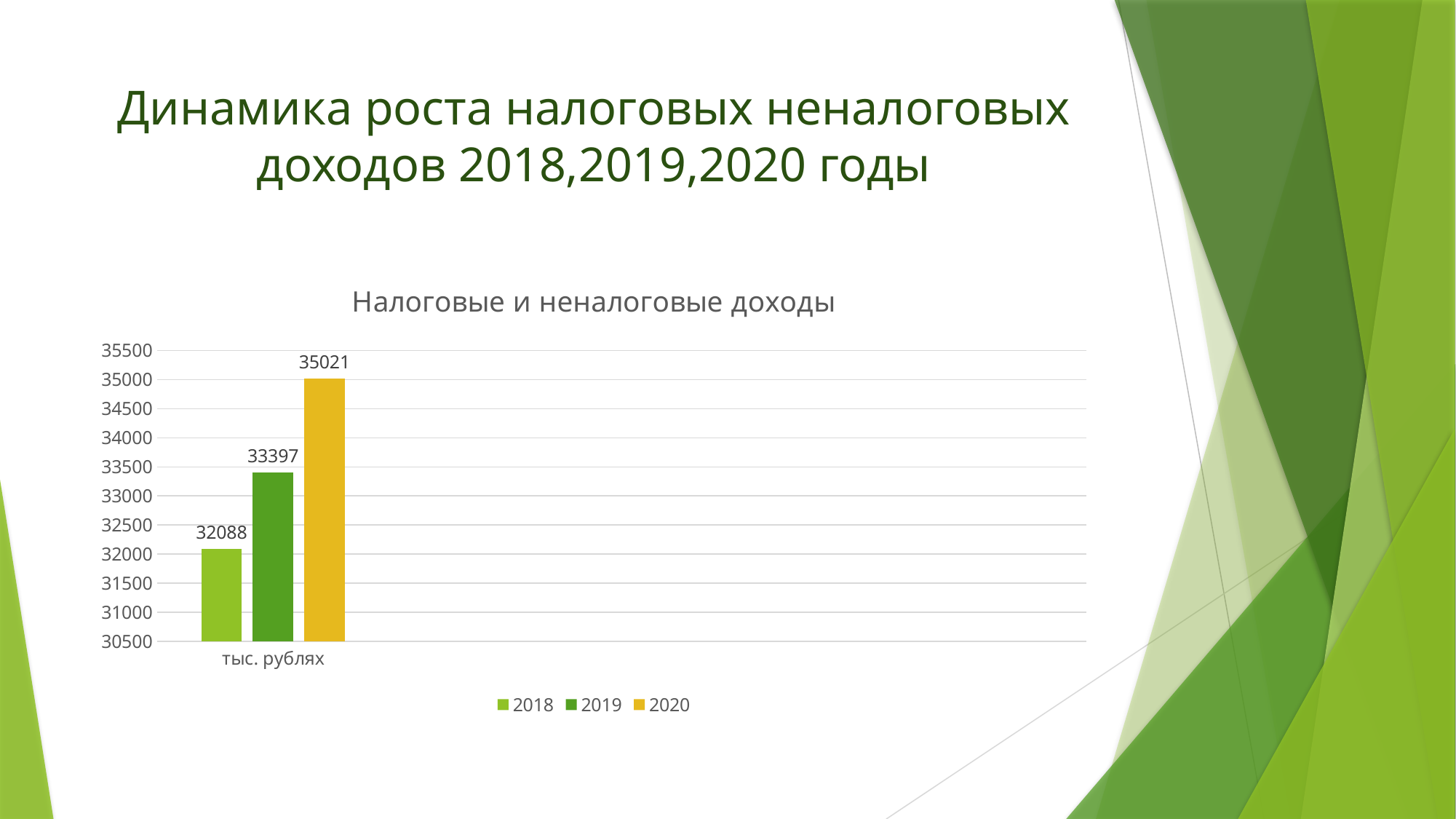
What is the value for 2019 in the chart? 33397 Which year has the lowest value? 2018 What is the value for 2018 in the chart? 32088 What is the difference between the 2020 and 2018 values? 2933 What kind of chart is shown on the slide? bar chart How many series does the legend list? 3 Which is larger, the value for 2019 or the value for 2020? 2020 What is the value for 2020 in the chart? 35021 What is the title of the chart? Налоговые и неналоговые доходы What is the difference between the 2019 and 2018 values? 1309 Which year has the highest value? 2020 Is the value for 2019 greater or less than 33000? greater